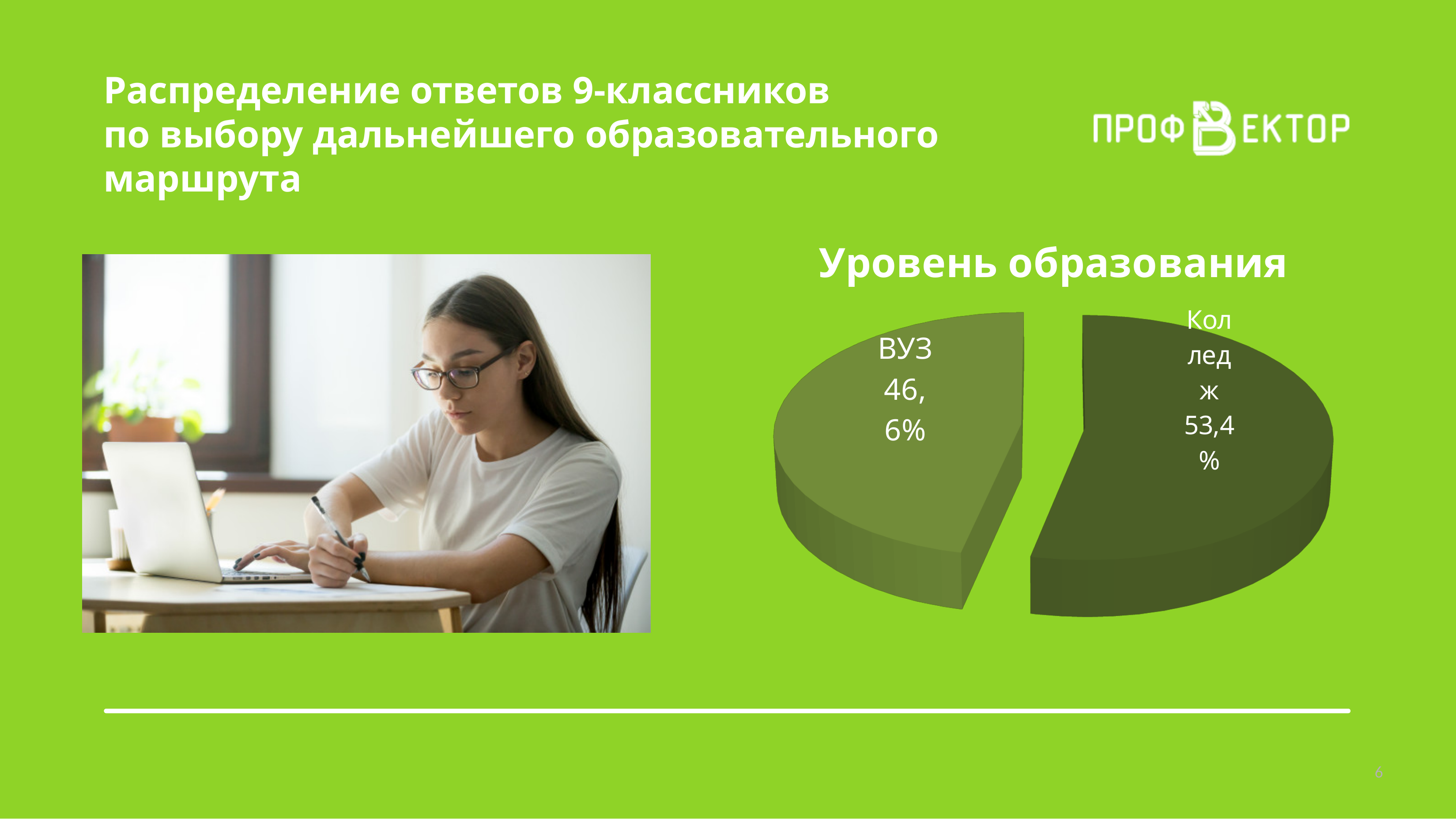
How many slices does the pie chart have? 2 By how many percentage points does Колледж exceed ВУЗ in the pie chart? 6,8 Is the share for Колледж greater or less than 50%? greater Which is larger in the pie chart, ВУЗ or Колледж? Колледж Which slice of the pie chart is the largest? Колледж What share of the pie chart is labelled ВУЗ? 46,6% Is the share for ВУЗ greater or less than 50%? less What kind of chart is shown on the slide? pie chart What share of the pie chart is labelled Колледж? 53,4% What is the title of the pie chart? Уровень образования Which slice of the pie chart is the smallest? ВУЗ